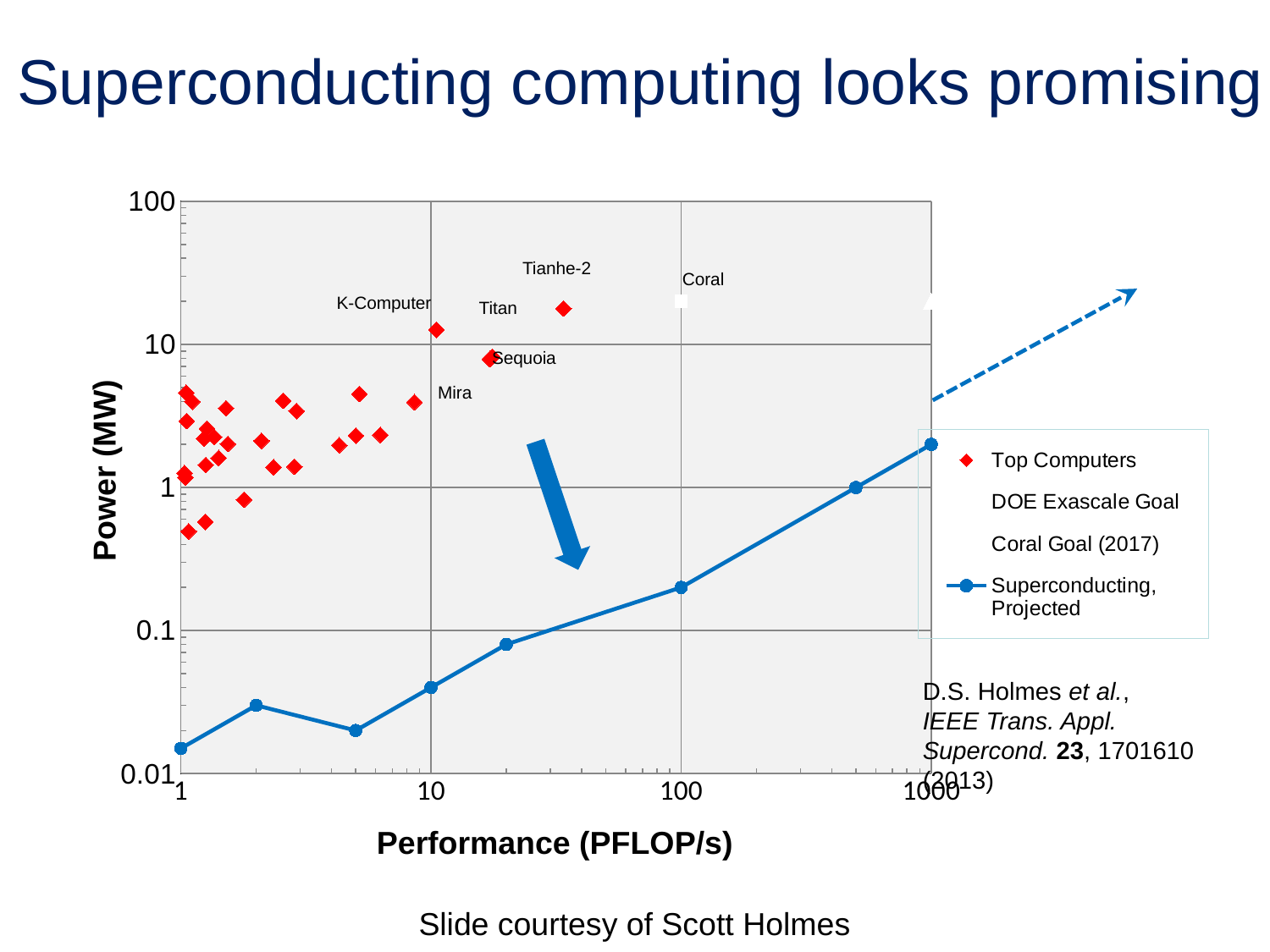
Is the Superconducting, Projected power value at 100 PFLOP/s greater or less than 1 MW? less Does the Superconducting, Projected line rise or fall as performance increases along the x axis? rises Is the power value for Tianhe-2 greater or less than 10 MW? greater Is the power value for Sequoia greater or less than 10 MW? less Which has the higher power value, Tianhe-2 or Sequoia? Tianhe-2 How many data points are plotted on the Superconducting, Projected line? 8 How many series does the chart's legend list? 4 What is the label of the y axis of the chart? Power (MW) What is the label of the x axis of the chart? Performance (PFLOP/s) What kind of chart is shown on the slide? scatter chart